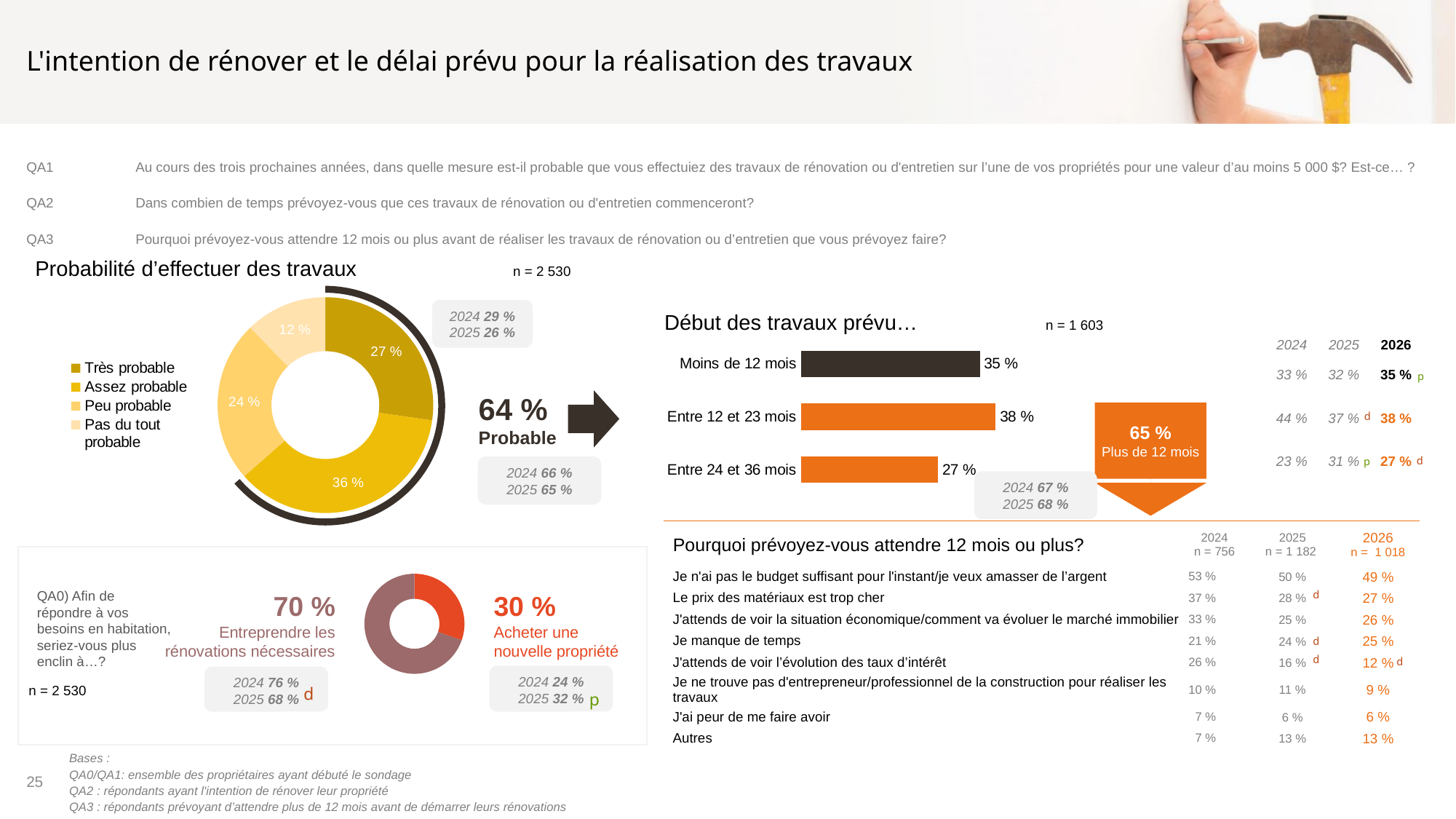
In the 'Probabilité d'effectuer des travaux' donut chart, how many categories does the legend list? 4 In the 'Début des travaux prévu…' chart, which category has the highest value? Entre 12 et 23 mois In the small donut chart at the bottom left (QA0), what share corresponds to 'Acheter une nouvelle propriété'? 30 % In the 'Début des travaux prévu…' chart, which is larger: 'Moins de 12 mois' or 'Entre 24 et 36 mois'? Moins de 12 mois In the 'Début des travaux prévu…' chart, what is the value for 'Entre 12 et 23 mois'? 38 % In the 'Probabilité d'effectuer des travaux' donut chart, what is the difference between 'Assez probable' and 'Peu probable'? 12 % What kind of chart is 'Début des travaux prévu…'? Bar chart In the 'Probabilité d'effectuer des travaux' donut chart, what share is 'Assez probable'? 36 % In the 'Début des travaux prévu…' chart, what is the value for 'Entre 24 et 36 mois'? 27 % In the 'Probabilité d'effectuer des travaux' donut chart, which category has the largest share? Assez probable In the 'Probabilité d'effectuer des travaux' donut chart, which category has the smallest share? Pas du tout probable In the 'Probabilité d'effectuer des travaux' donut chart, what share is 'Très probable'? 27 %